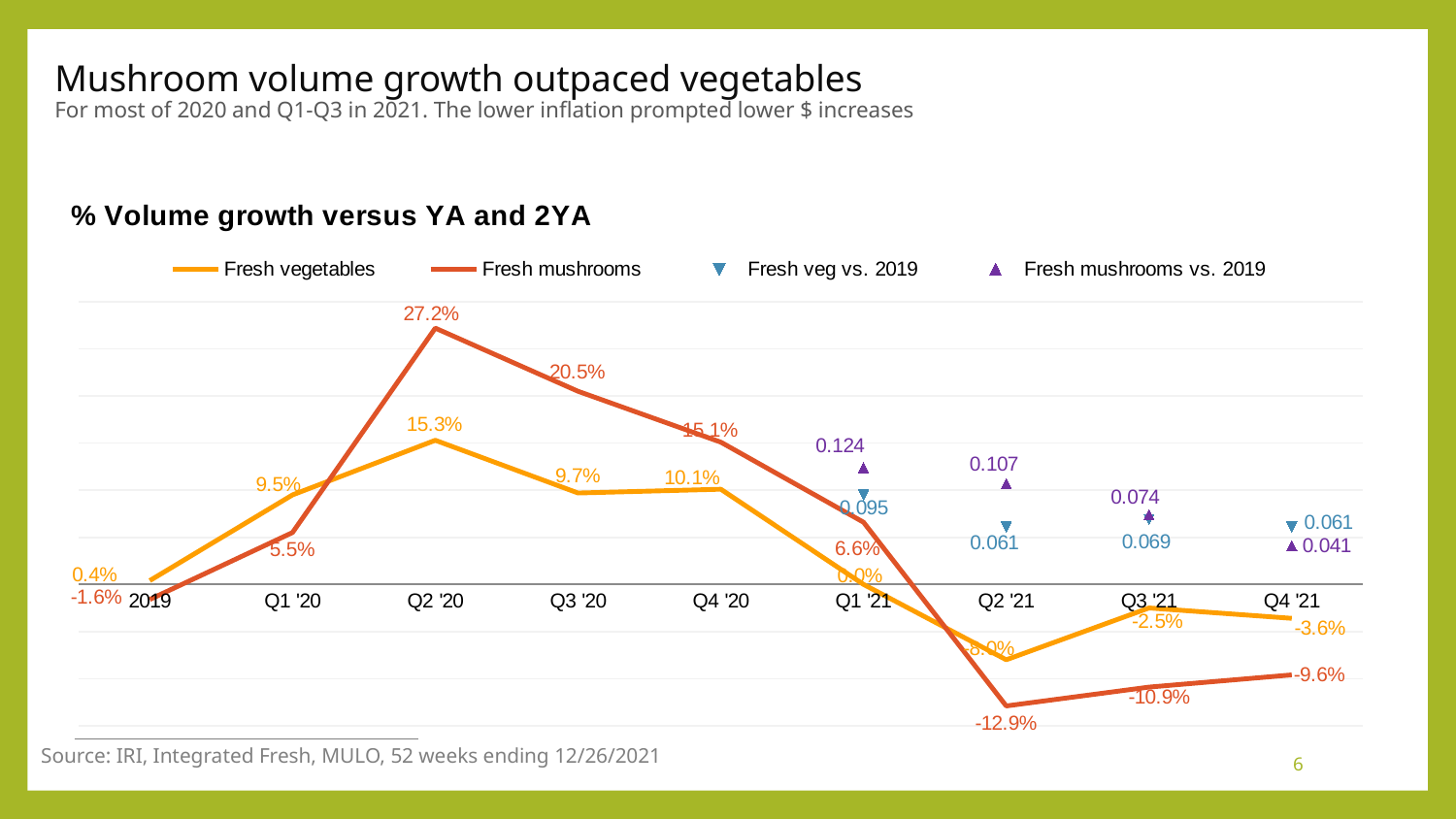
What is the value for Fresh mushrooms in Q2 '20? 27.2% How many periods are shown on the x axis? 9 What is the value for Fresh mushrooms vs. 2019 in Q1 '21? 0.124 What is the value for Fresh mushrooms in Q4 '21? -9.6% In Q3 '20, which is larger: Fresh mushrooms or Fresh vegetables? Fresh mushrooms What is the value for Fresh vegetables in Q2 '20? 15.3% In which period does the Fresh mushrooms series reach its highest value? Q2 '20 In which period does the Fresh mushrooms series reach its lowest value? Q2 '21 Does the Fresh mushrooms series rise or fall from Q2 '20 to Q2 '21? Fall How many series does the legend list? 4 What is the difference between Fresh mushrooms and Fresh vegetables in Q2 '20? 11.9 percentage points What kind of chart is this? Line chart